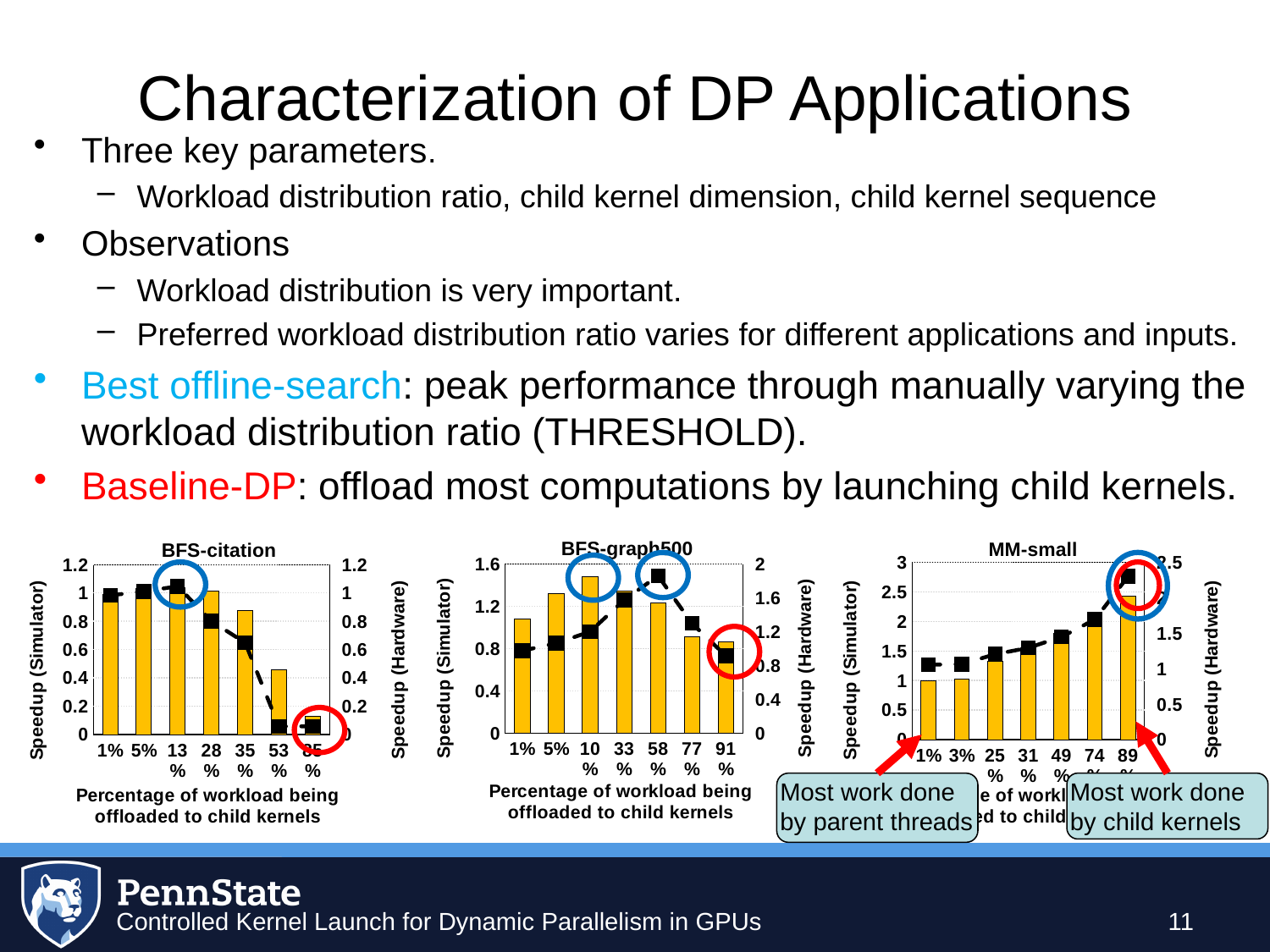
How many workload percentage categories are shown on the x axis of the BFS-citation chart? 7 In the MM-small chart, do the Speedup (Simulator) bars rise or fall as the percentage of workload offloaded increases? rise In the BFS-graph500 chart, is the Speedup (Simulator) bar for 10% greater or less than 1.2? greater In the MM-small chart, which workload percentage has the highest Speedup (Simulator) bar? 89% In the BFS-citation chart, which workload percentage has the lowest Speedup (Simulator) bar? 85% What kind of chart is the BFS-citation chart? bar chart with a line What is the label of the left vertical axis on the MM-small chart? Speedup (Simulator) In the BFS-graph500 chart, which has the larger Speedup (Simulator) bar, 5% or 91%? 5% In the BFS-citation chart, is the Speedup (Simulator) bar for 53% greater or less than 0.6? less In the MM-small chart, is the Speedup (Simulator) bar for 89% greater or less than 2? greater In the BFS-graph500 chart, which workload percentage has the highest Speedup (Simulator) bar? 10% In the BFS-citation chart, do the Speedup (Simulator) bars generally rise or fall as the percentage of workload offloaded increases? fall